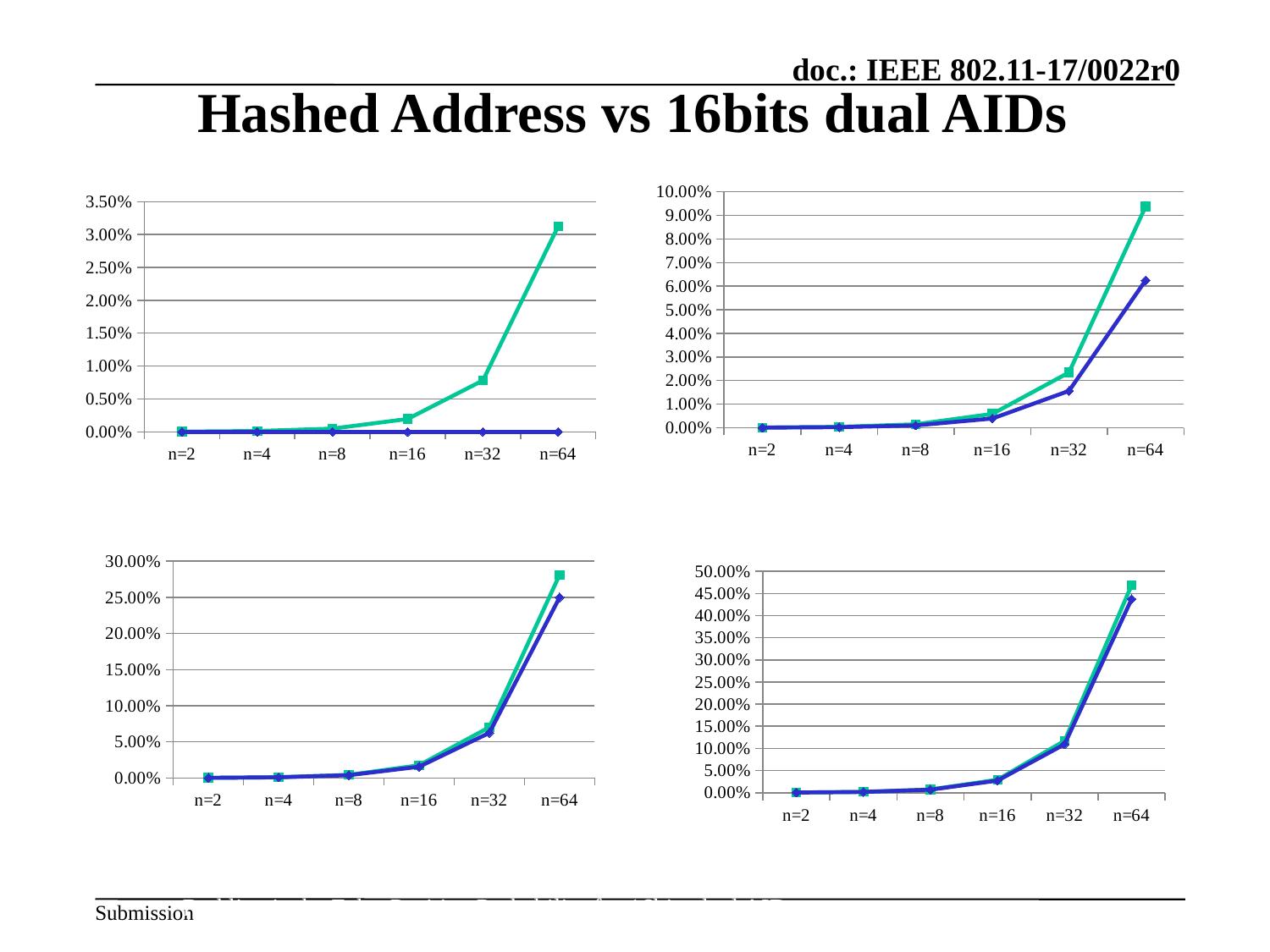
In the bottom-right chart, do the values of the green line rise or fall as n increases from n=2 to n=64? rise In the top-right chart, is the value of the blue line at n=64 greater or less than 7.00%? less In the bottom-left chart, at which x-axis category does the green line reach its highest value? n=64 In the bottom-left chart, is the value of the green line at n=64 greater or less than 25.00%? greater In the top-right chart, which line has the higher value at n=64, the green line or the blue line? the green line What kind of chart is the top-left chart on the slide? line chart How many categories are shown on the x axis of the top-right chart? 6 In the top-left chart, is the value of the blue line at n=64 greater or less than 0.50%? less What is the title of the slide containing the four charts? Hashed Address vs 16bits dual AIDs